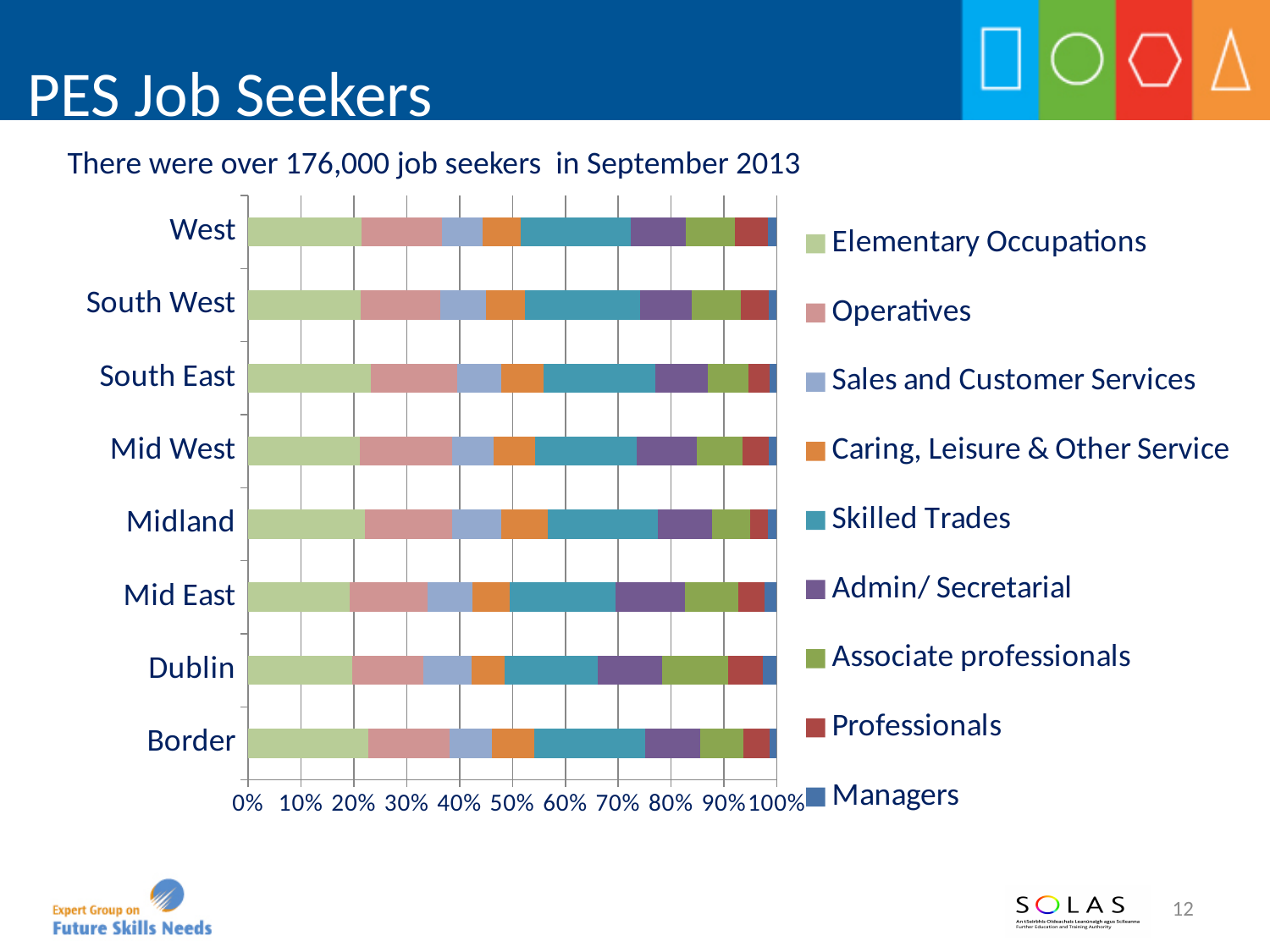
Is the Elementary Occupations share for Midland greater or less than 30%? less How many series does the legend list? 9 What kind of chart is shown on the slide? Stacked bar chart What is the highest value shown on the x axis? 100% Is the Elementary Occupations share for Border greater or less than 20%? greater Is the Elementary Occupations share for West greater or less than 30%? less Which region has the larger Elementary Occupations share, South East or Dublin? South East Which series is listed first in the legend? Elementary Occupations Which series is listed last in the legend? Managers How many regions are plotted on the chart? 8 Which region has the larger Elementary Occupations share, South East or Mid East? South East